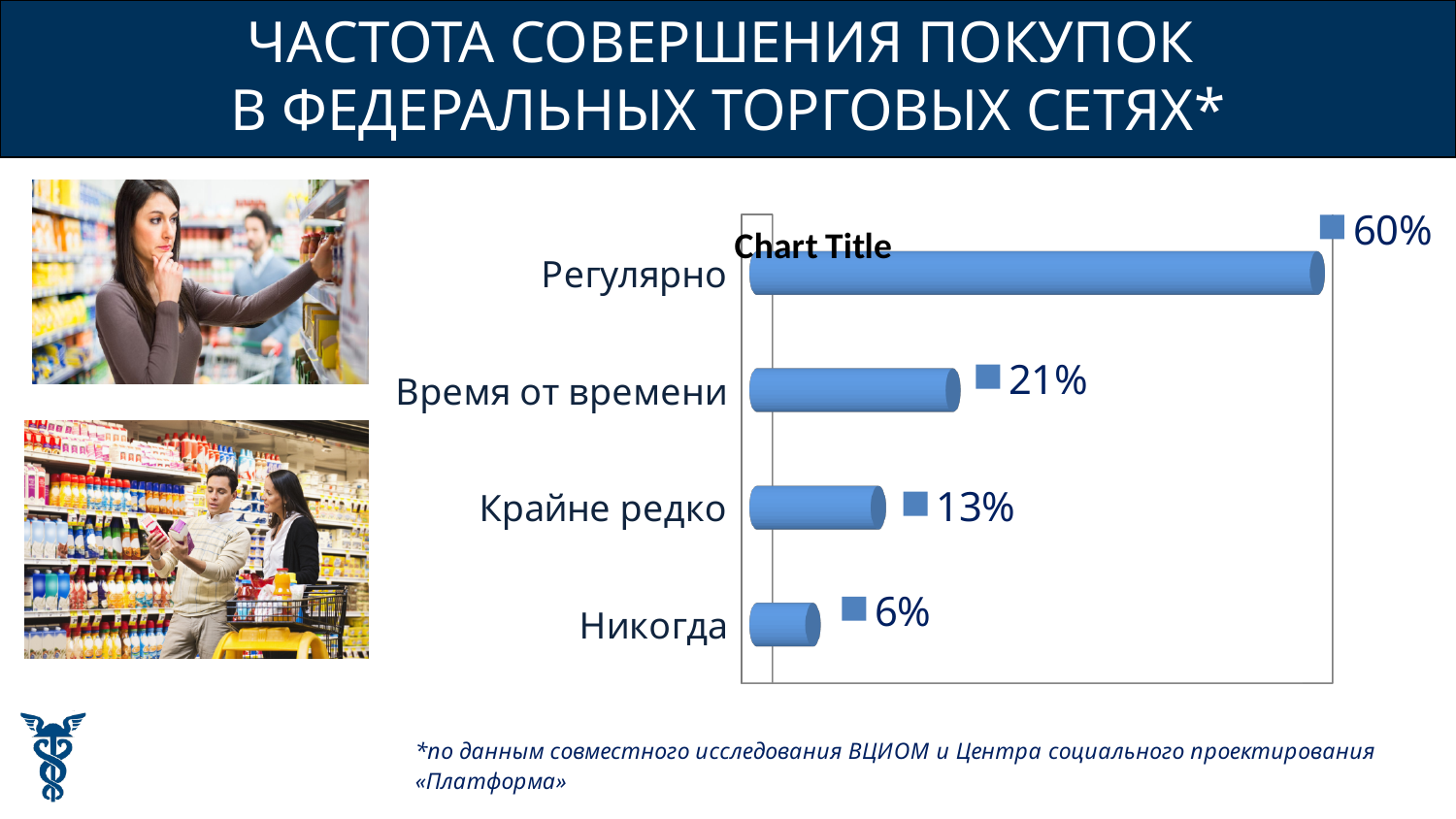
How many categories are shown in the chart? 4 What is the title printed inside the chart area? Chart Title What is the value for Регулярно? 60% What kind of chart is shown on the slide? Bar chart What is the value for Время от времени? 21% What is the difference between the values for Регулярно and Время от времени? 39% Which is larger, the value for Время от времени or the value for Крайне редко? Время от времени What is the difference between the values for Крайне редко and Никогда? 7% What is the value for Никогда? 6% Which category has the lowest value? Никогда Which category has the highest value? Регулярно What is the value for Крайне редко? 13%